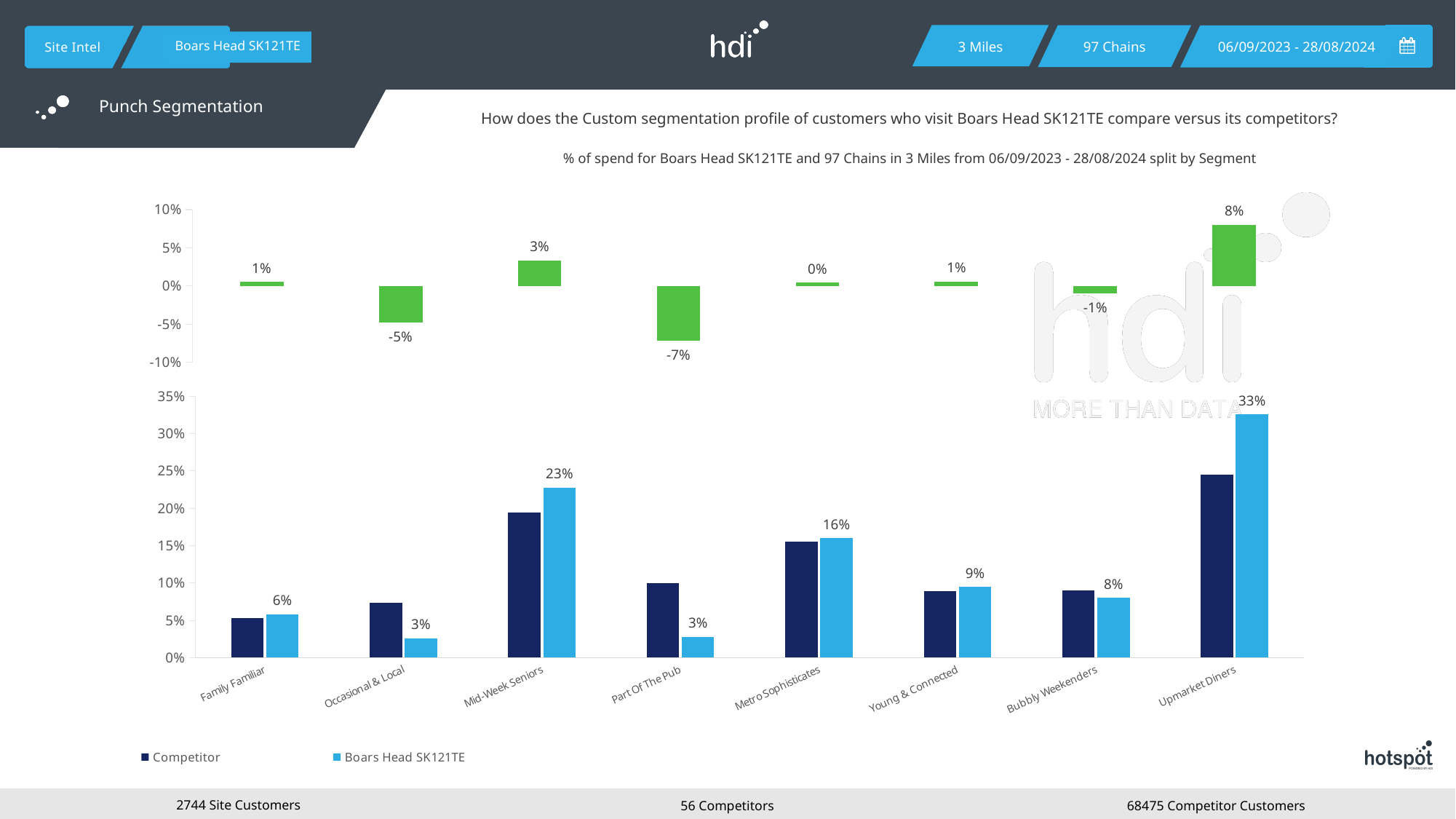
In the bottom chart, is the Competitor value for Upmarket Diners greater or less than 20%? greater In the bottom chart, what is the difference between the Boars Head SK121TE values for Upmarket Diners and Mid-Week Seniors? 10% In the top chart, what is the value shown for Occasional & Local? -5% What type of chart is the bottom chart? Bar chart In the top chart, what is the value shown for Part Of The Pub? -7% In the top chart, which segment has the highest value? Upmarket Diners How many series does the legend of the bottom chart list? 2 In the bottom chart, for Occasional & Local, which is larger: the Competitor bar or the Boars Head SK121TE bar? Competitor In the bottom chart, which segment has the highest Boars Head SK121TE value? Upmarket Diners How many segments are shown along the x axis of the bottom chart? 8 In the bottom chart, what is the value for Boars Head SK121TE in the Mid-Week Seniors segment? 23% In the top chart, which segment has the lowest value? Part Of The Pub